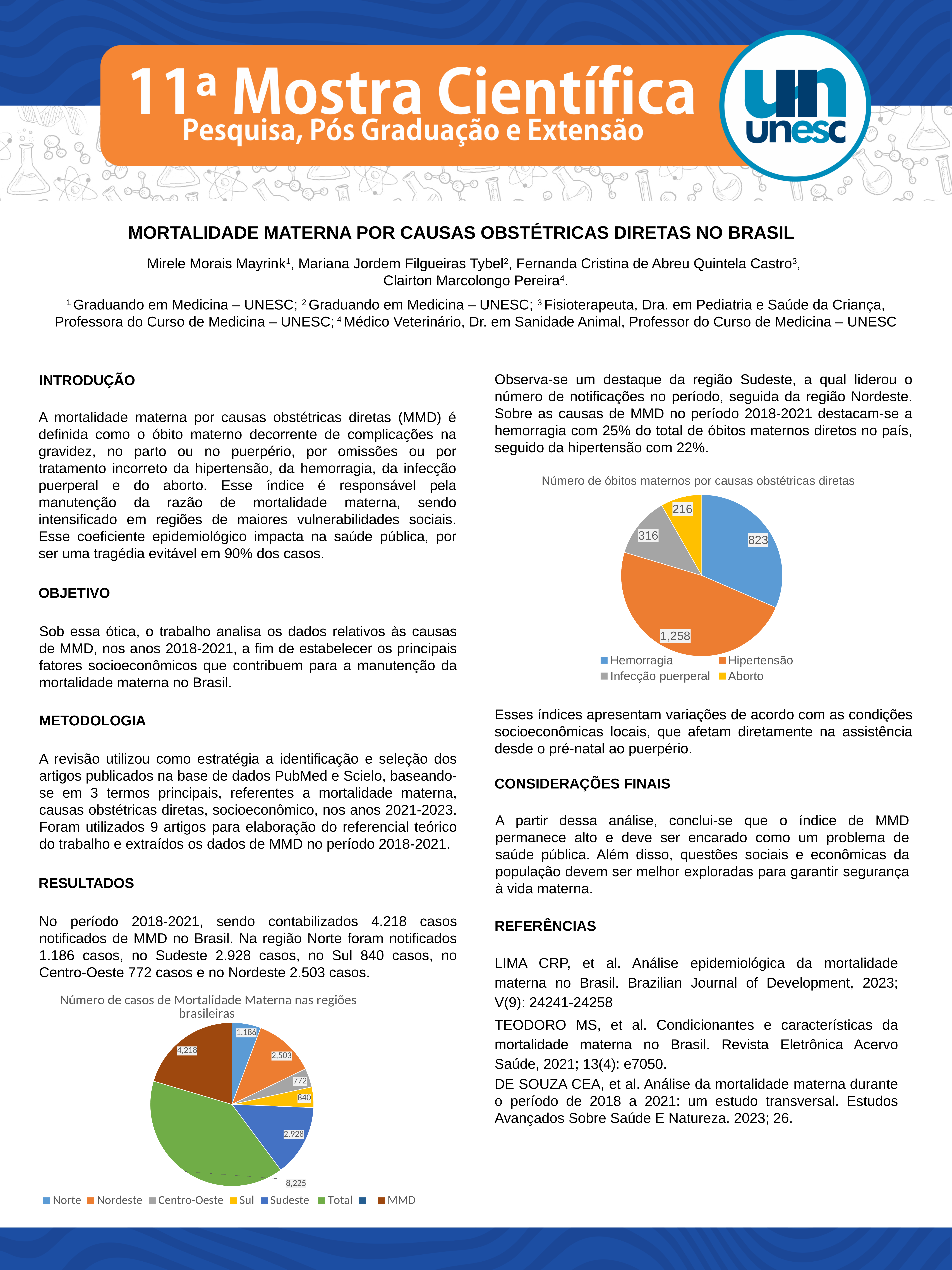
What kind of chart is the one titled 'Número de óbitos maternos por causas obstétricas diretas'? Pie chart In the chart titled 'Número de óbitos maternos por causas obstétricas diretas', how many categories are shown in the legend? 4 In the chart titled 'Número de óbitos maternos por causas obstétricas diretas', which category has the largest slice? Hipertensão In the chart titled 'Número de óbitos maternos por causas obstétricas diretas', what is the value for Hipertensão? 1,258 In the chart titled 'Número de casos de Mortalidade Materna nas regiões brasileiras', what is the value for Centro-Oeste? 772 In the chart titled 'Número de casos de Mortalidade Materna nas regiões brasileiras', which is larger, Nordeste or Sudeste? Sudeste In the chart titled 'Número de óbitos maternos por causas obstétricas diretas', what is the value for Aborto? 216 In the chart titled 'Número de óbitos maternos por causas obstétricas diretas', what is the difference between Hipertensão and Hemorragia? 435 In the chart titled 'Número de óbitos maternos por causas obstétricas diretas', which category has the smallest slice? Aborto In the chart titled 'Número de casos de Mortalidade Materna nas regiões brasileiras', what is the value for Sudeste? 2,928 In the chart titled 'Número de casos de Mortalidade Materna nas regiões brasileiras', what is the difference between Sudeste and Nordeste? 425 In the chart titled 'Número de casos de Mortalidade Materna nas regiões brasileiras', what colour is the Sul slice? Yellow